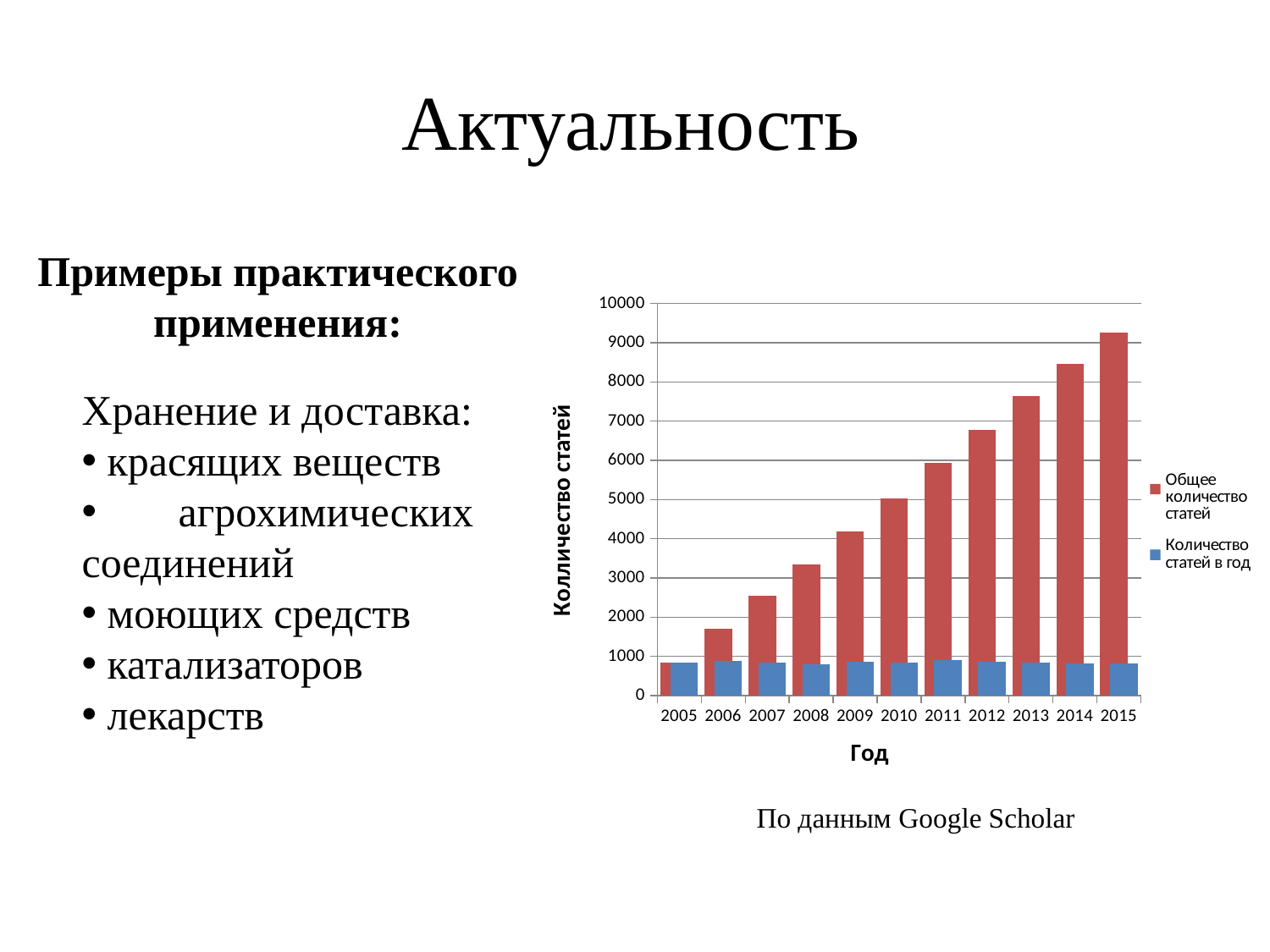
Is the value for "Общее количество статей" in 2008 greater or less than 3000? greater How many series does the chart legend list? 2 What is the title of the vertical axis of the chart? Количество статей Which year has the highest value for "Общее количество статей"? 2015 Which is larger: "Общее количество статей" in 2013 or in 2009? 2013 Is the value for "Количество статей в год" in 2010 greater or less than 1000? less Do the values for "Общее количество статей" rise or fall from 2005 to 2015? rise Which year has the lowest value for "Общее количество статей"? 2005 Is the value for "Общее количество статей" in 2012 greater or less than 7000? less How many years are shown on the x axis of the chart? 11 What kind of chart is shown on the slide? bar chart